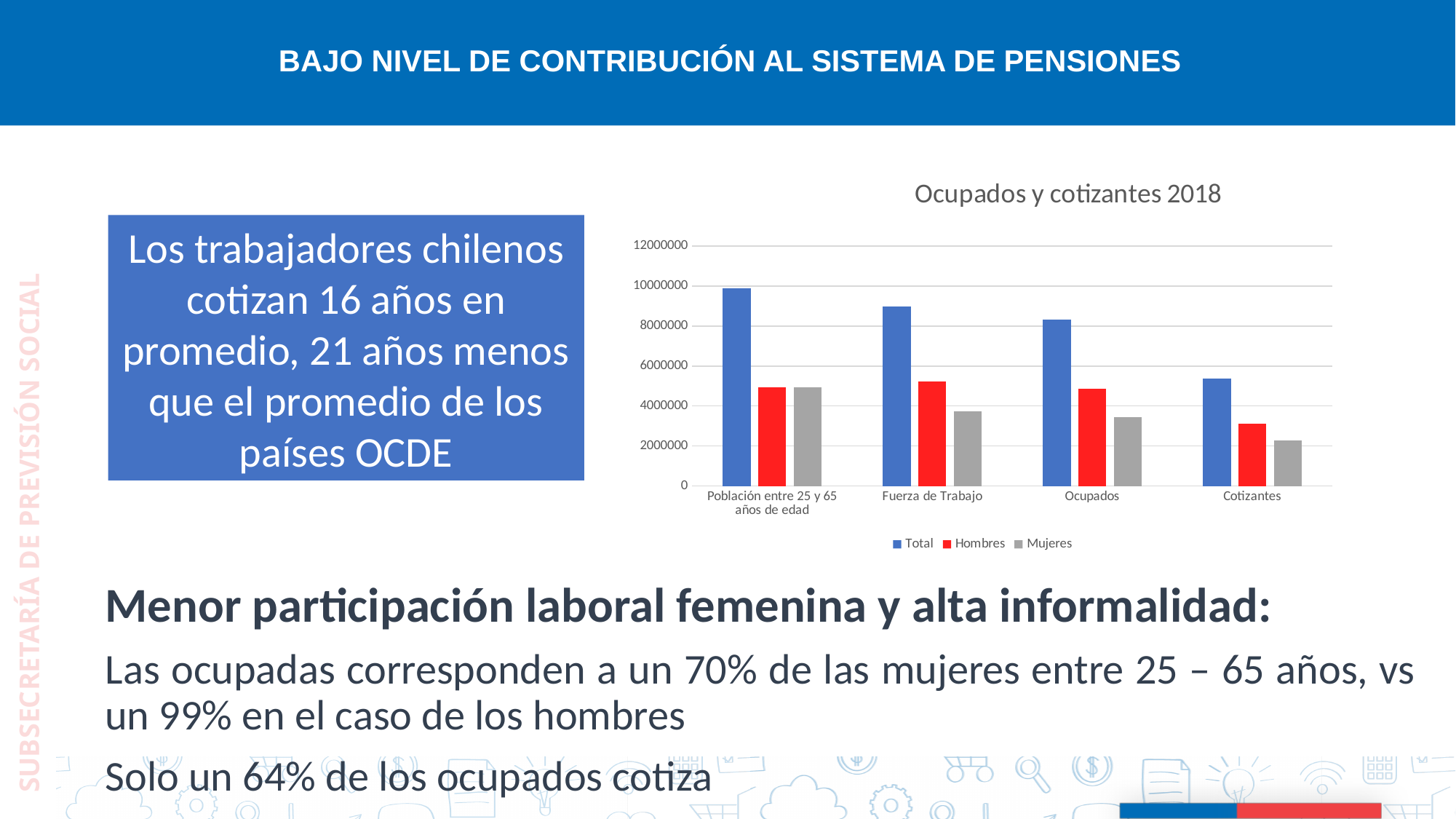
Which colour represents the Mujeres series in the chart? grey For Fuerza de Trabajo, which is larger: Hombres or Mujeres? Hombres Which category has the lowest Total value? Cotizantes Do the Total values rise or fall moving from left to right across the categories? fall What kind of chart is shown on the slide? bar chart What is the title of the chart? Ocupados y cotizantes 2018 Is the Total value for Cotizantes greater or less than 6000000? less Is the Total value for Ocupados greater or less than 8000000? greater How many categories are shown on the x axis of the chart? 4 Which category has the highest Total value? Población entre 25 y 65 años de edad Is the Mujeres value for Cotizantes greater or less than 2000000? greater How many series does the chart legend list? 3